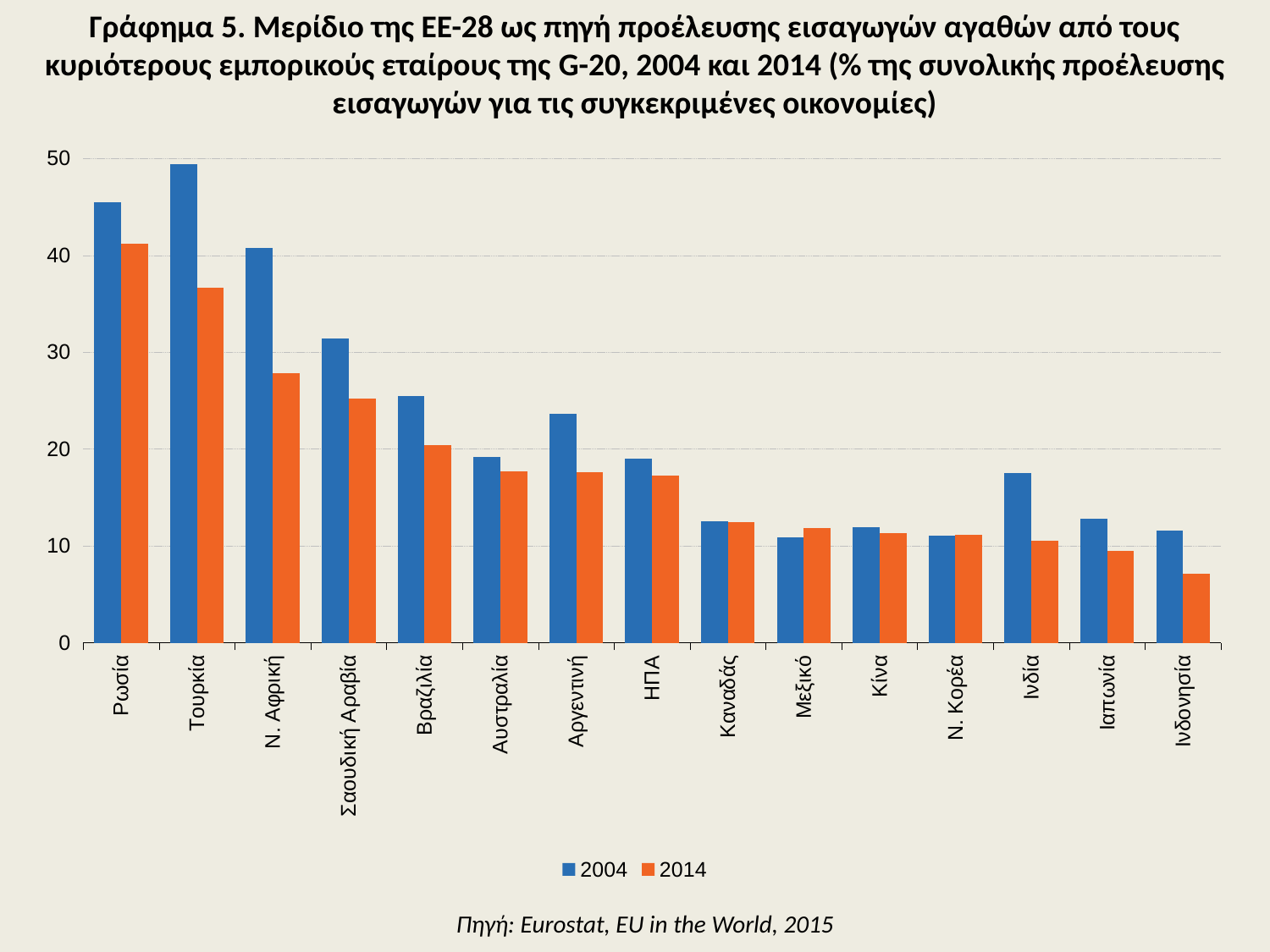
Is the 2014 value for Τουρκία greater or less than 40? less Is the 2014 value for Ν. Αφρική greater or less than 30? less For Ινδία, which year has the larger value, 2004 or 2014? 2004 Is the 2014 value for Ινδονησία greater or less than 10? less Do the 2014 values rise or fall moving from left to right along the x axis? fall What kind of chart is shown on the slide? bar chart How many series does the legend list? 2 Which country has the highest value for 2004? Τουρκία Which country has the highest value for 2014? Ρωσία Which country has the lowest value for 2014? Ινδονησία How many countries are shown on the x axis of the chart? 15